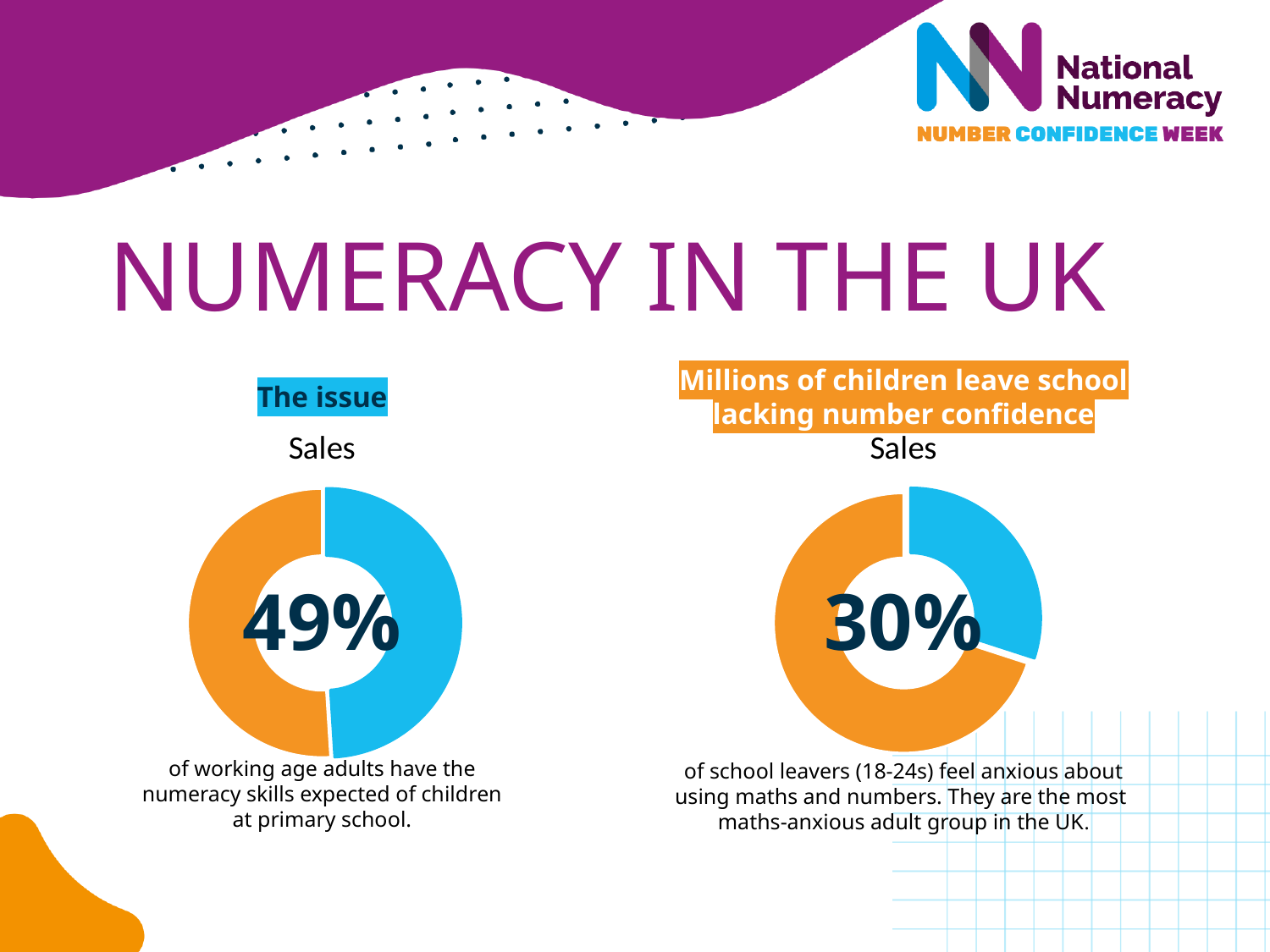
What title is printed directly above the left doughnut chart? Sales In the left chart under "The issue", what percentage is printed in the centre of the doughnut? 49% What kind of chart is shown on the left side of the slide under "The issue"? Doughnut chart What is the difference between the percentage shown in the left chart and the percentage shown in the right chart? 19% In the right chart under "Millions of children leave school lacking number confidence", what percentage is printed in the centre of the doughnut? 30% What two colours are used for the slices in the right doughnut chart? Blue and orange In the left chart, is the value printed in the centre greater or less than 50%? less How many slices does the right doughnut chart under "Millions of children leave school lacking number confidence" have? 2 Which chart shows the larger highlighted percentage, the left chart (working age adults) or the right chart (school leavers)? The left chart How many slices does the left doughnut chart under "The issue" have? 2 What kind of chart is shown on the right side of the slide under "Millions of children leave school lacking number confidence"? Doughnut chart In the right chart, is the blue slice larger or smaller than the orange slice? Smaller